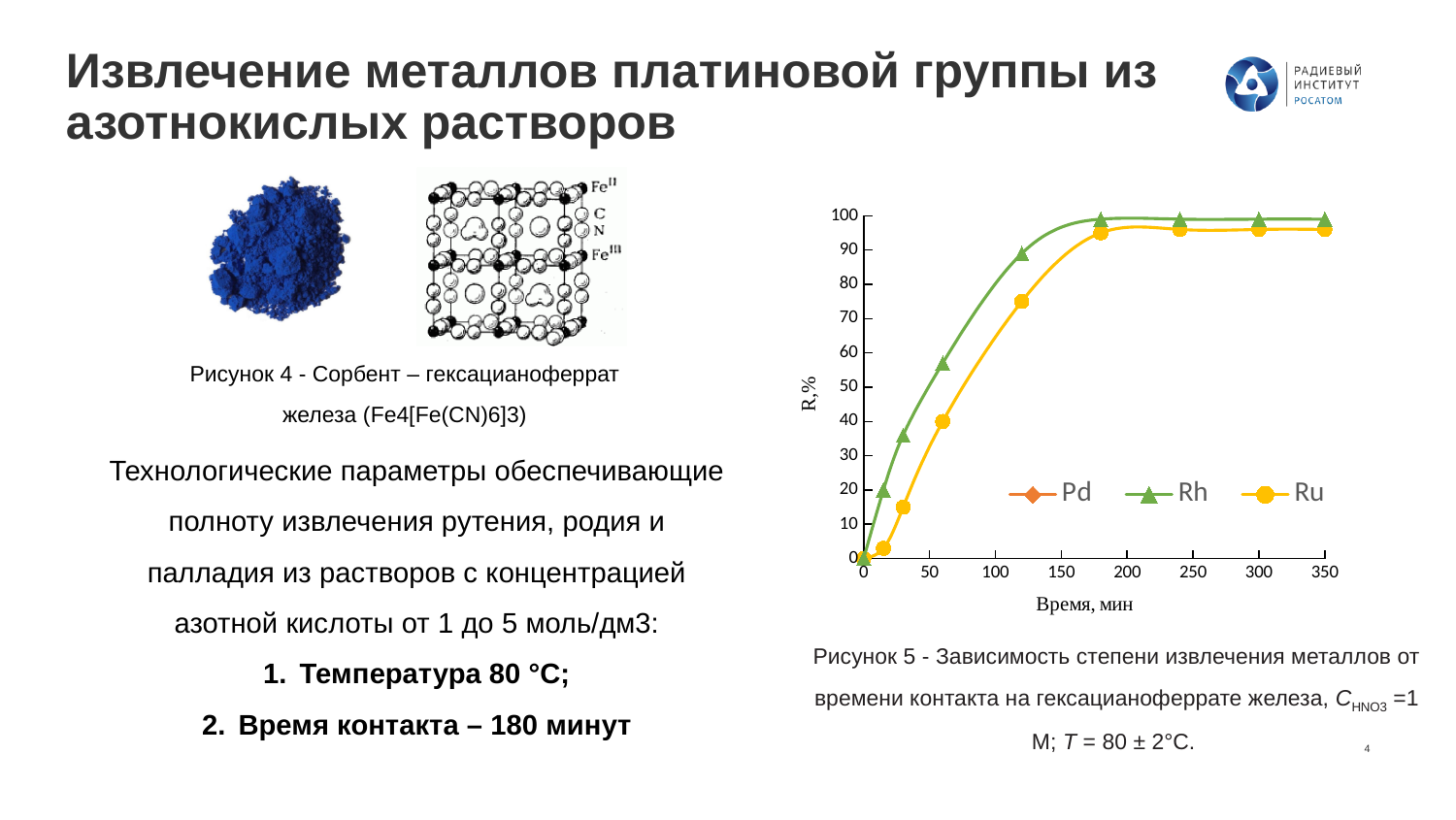
What kind of chart is shown in Рисунок 5? line chart Is the value for Rh at 60 min greater or less than 50? greater Is the value for Rh at 120 min greater or less than 80? greater Do the values for Ru rise or fall as time increases from 0 to 180 min? rise What is the label of the x axis of the chart? Время, мин Is the value for Ru at 60 min greater or less than 50? less How many series does the legend of the chart list? 3 What are the series names listed in the chart legend? Pd, Rh, Ru At 60 min, which series has the larger value, Rh or Ru? Rh At 120 min, which series has the larger value, Rh or Ru? Rh